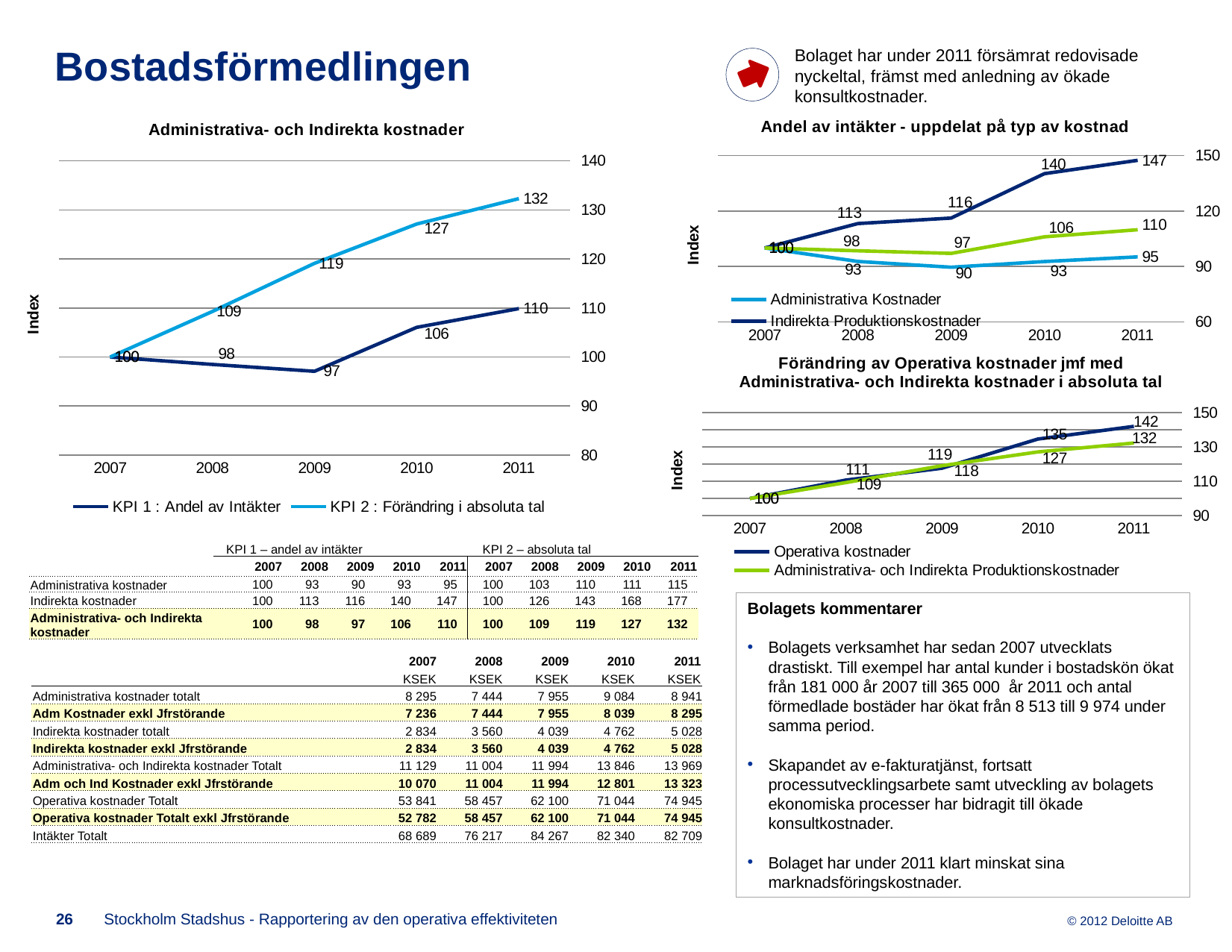
In the chart titled 'Administrativa- och Indirekta kostnader', what is the difference between KPI 2 and KPI 1 in 2010? 21 In the chart titled 'Administrativa- och Indirekta kostnader', what is the value of KPI 1 : Andel av Intäkter in 2009? 97 In the chart titled 'Andel av intäkter - uppdelat på typ av kostnad', what is the value of Indirekta Produktionskostnader in 2011? 147 In the chart titled 'Andel av intäkter - uppdelat på typ av kostnad', which series is higher in 2010: Administrativa Kostnader or Indirekta Produktionskostnader? Indirekta Produktionskostnader In the chart titled 'Förändring av Operativa kostnader jmf med Administrativa- och Indirekta kostnader i absoluta tal', what is the value of Operativa kostnader in 2010? 135 In the chart titled 'Administrativa- och Indirekta kostnader', in which year is KPI 1 : Andel av Intäkter lowest? 2009 In the chart titled 'Administrativa- och Indirekta kostnader', how many series does the legend list? 2 What type of chart is 'Administrativa- och Indirekta kostnader'? Line chart In the chart titled 'Förändring av Operativa kostnader jmf med Administrativa- och Indirekta kostnader i absoluta tal', how many years are shown on the x axis? 5 In the chart titled 'Andel av intäkter - uppdelat på typ av kostnad', what is the value of Administrativa Kostnader in 2009? 90 In the chart titled 'Förändring av Operativa kostnader jmf med Administrativa- och Indirekta kostnader i absoluta tal', what is the difference between Operativa kostnader and Administrativa- och Indirekta Produktionskostnader in 2011? 10 In the chart titled 'Administrativa- och Indirekta kostnader', what is the value of KPI 2 : Förändring i absoluta tal in 2011? 132